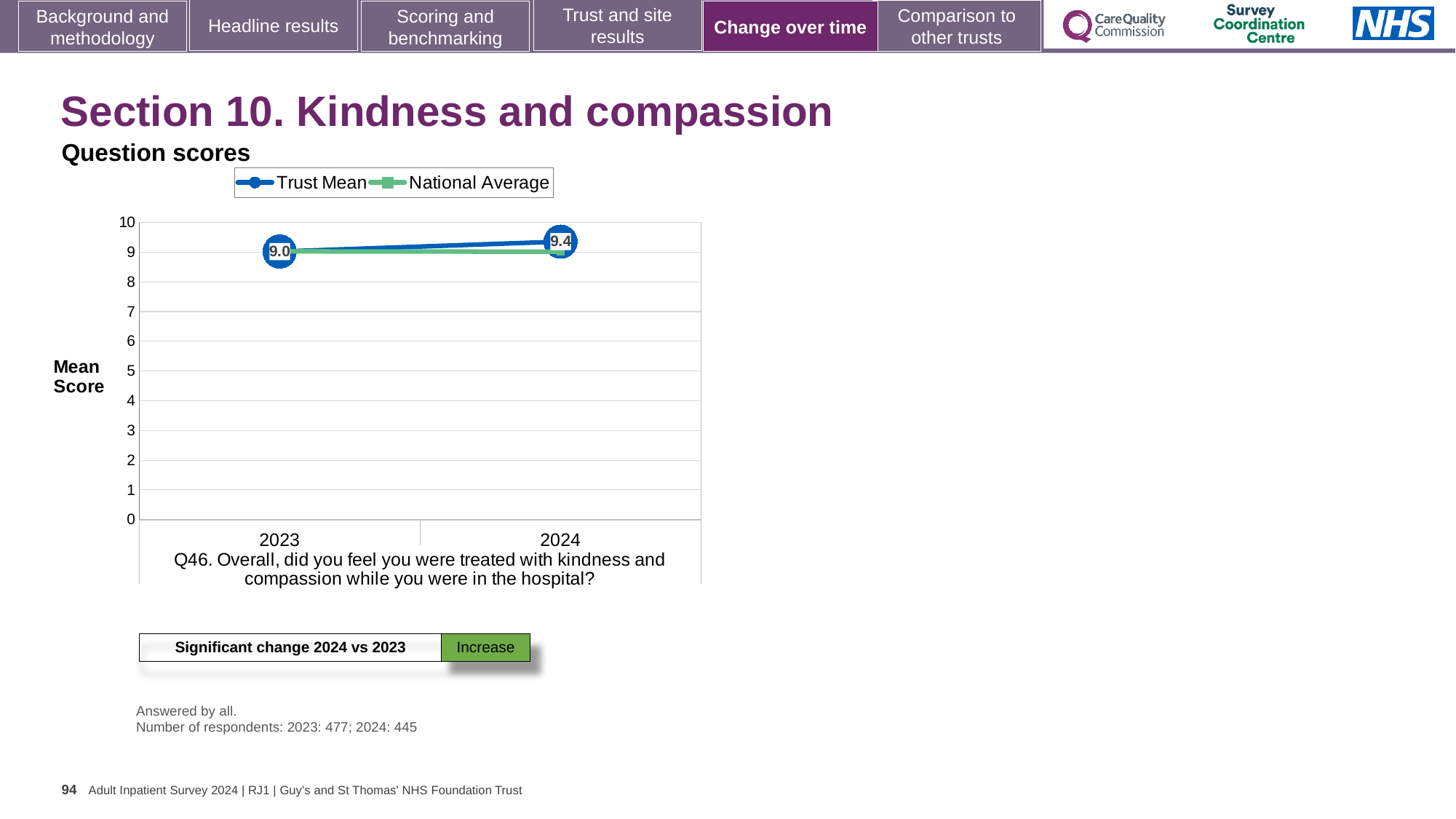
What is the Trust Mean score for 2024? 9.4 What kind of chart is shown? line chart How many series does the legend list? 2 How many years are plotted on the x axis? 2 Does the Trust Mean rise or fall from 2023 to 2024? rise What are the two series named in the legend? Trust Mean and National Average What is the label on the y axis? Mean Score Is the National Average value for 2024 greater or less than 5? greater In which year is the Trust Mean highest? 2024 By how much did the Trust Mean change from 2023 to 2024? 0.4 What is the Trust Mean score for 2023? 9.0 Which year has the higher Trust Mean, 2023 or 2024? 2024